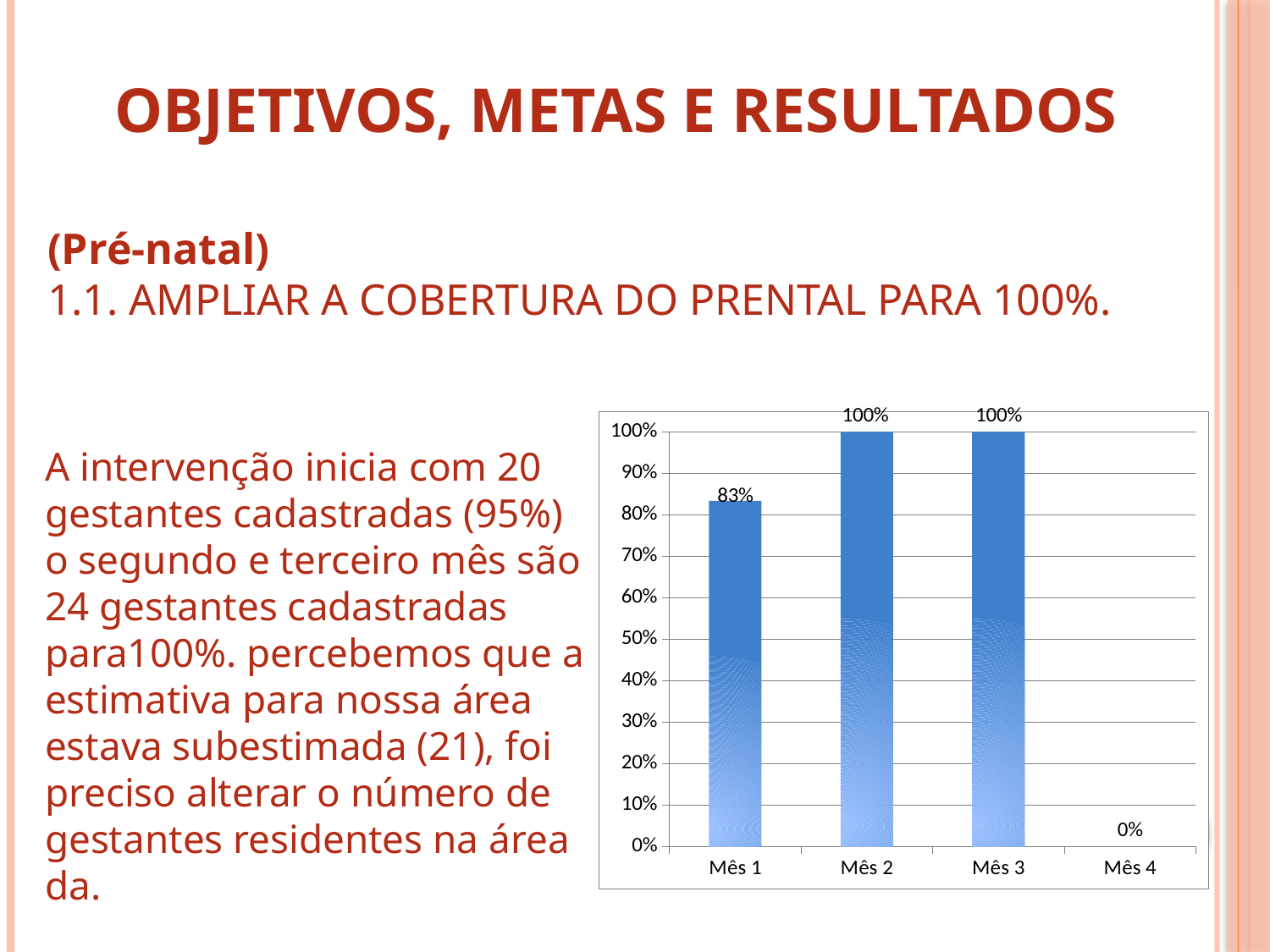
What is the value for Mês 1? 83% What is the difference between the values for Mês 2 and Mês 1? 17% Does the value rise or fall from Mês 3 to Mês 4? fall Which category has the lowest value? Mês 4 What is the value for Mês 4? 0% How many categories are shown on the x axis? 4 What kind of chart is shown on the slide? bar chart What is the value for Mês 2? 100% Is the value for Mês 1 greater or less than 90%? less Which is larger, the value for Mês 1 or the value for Mês 3? Mês 3 Does the value rise or fall from Mês 1 to Mês 2? rise What is the highest value shown on the y axis? 100%